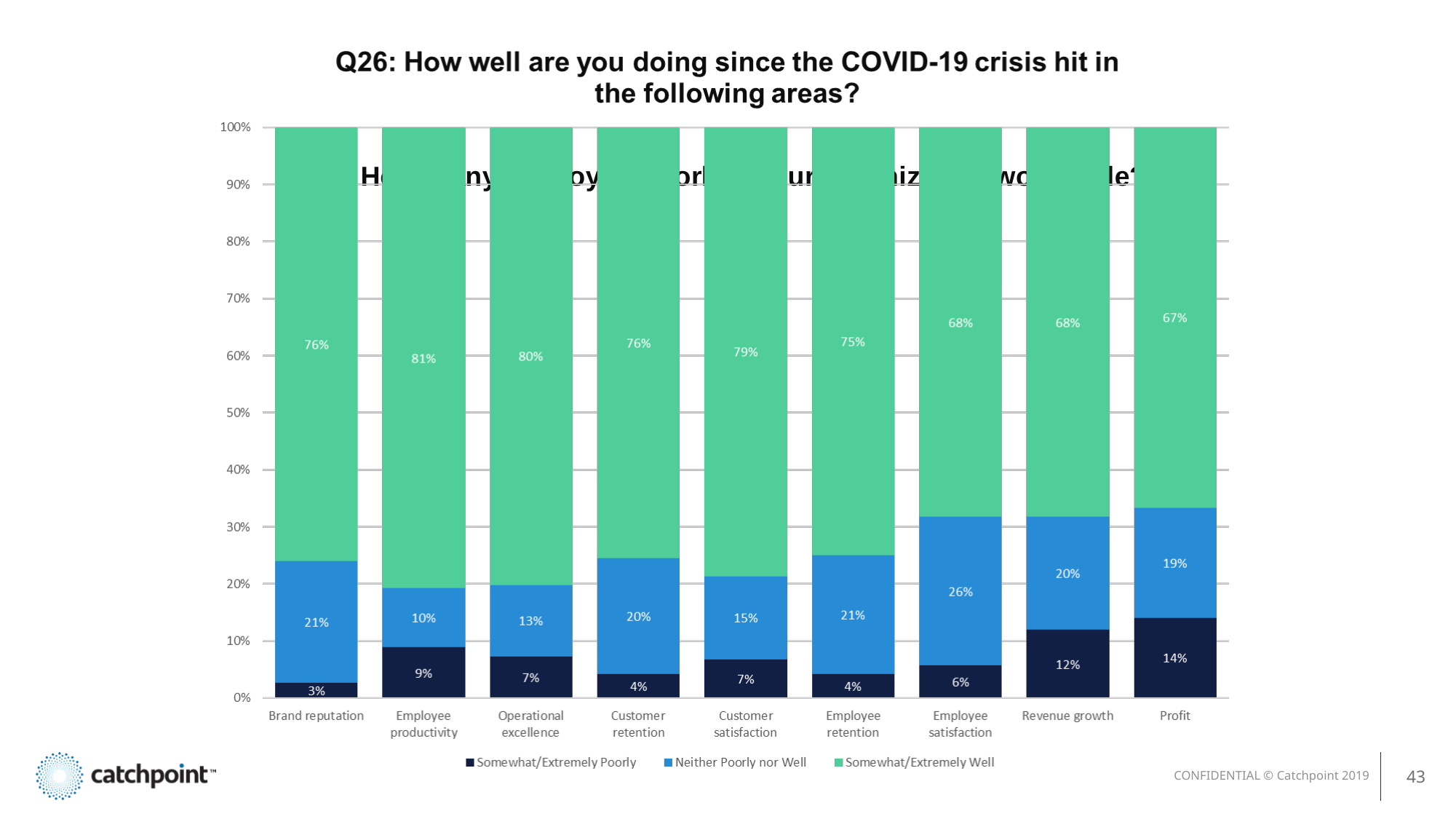
Which area has the lowest Somewhat/Extremely Poorly percentage? Brand reputation What is the Somewhat/Extremely Poorly value for Profit? 14% Which is larger, the Somewhat/Extremely Poorly value for Revenue growth or for Employee productivity? Revenue growth Which area has the highest Somewhat/Extremely Well percentage? Employee productivity How many areas (categories) are shown on the x axis? 9 How many series does the legend list? 3 What is the total of the stacked bar for Customer satisfaction (7%, 15% and 79%)? 101% What kind of chart is shown on the slide? Stacked bar chart What percentage of respondents said they are doing Somewhat/Extremely Well in Employee productivity? 81% What is the difference between the Somewhat/Extremely Well values for Operational excellence and Revenue growth? 12% What is the Neither Poorly nor Well value for Employee satisfaction? 26% Which area has the lowest Somewhat/Extremely Well percentage? Profit